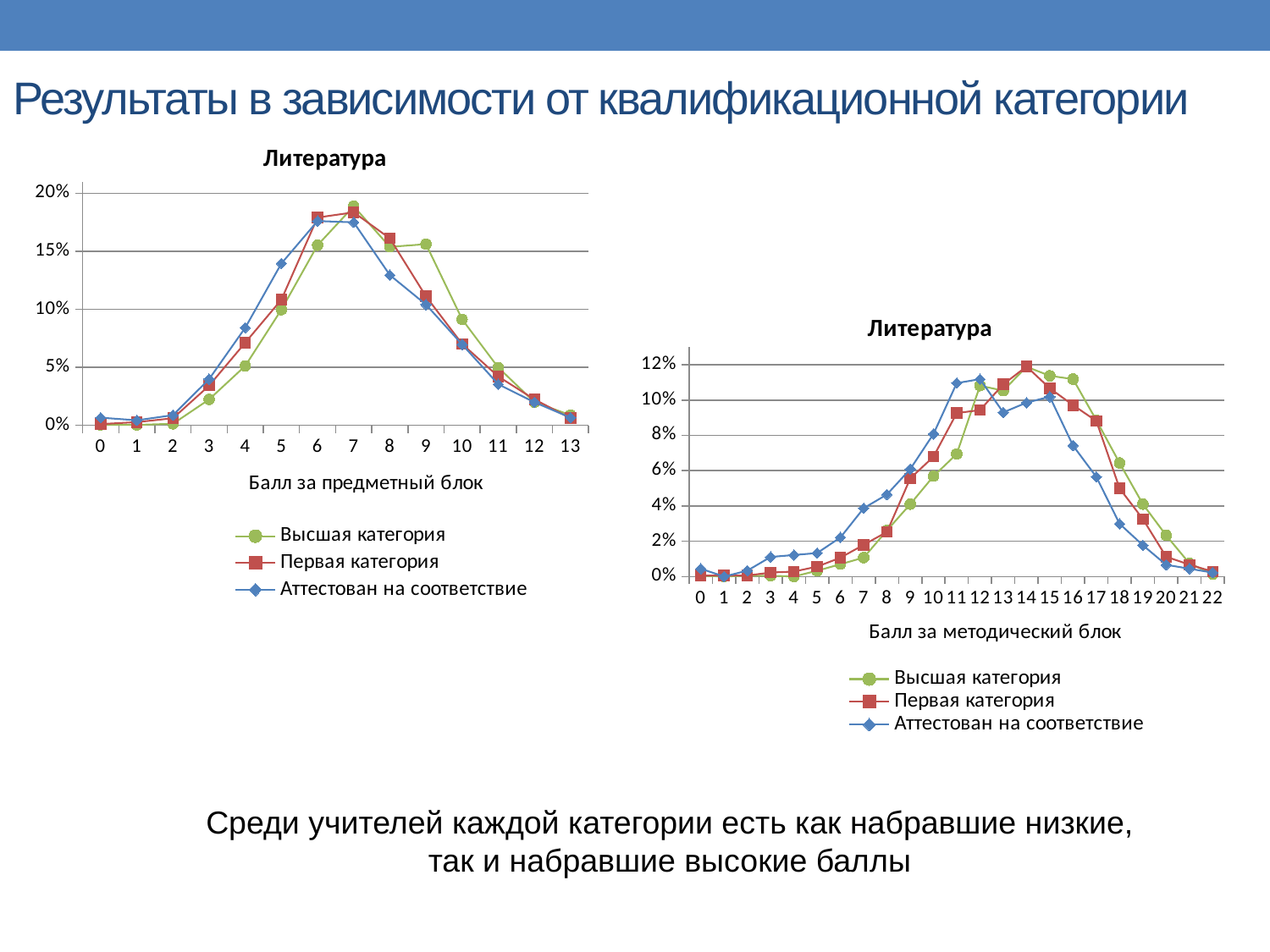
In the right chart (Балл за методический блок), at score 16, which is larger: Высшая категория or Аттестован на соответствие? Высшая категория In the left chart (Балл за предметный блок), at score 5, which is larger: Аттестован на соответствие or Высшая категория? Аттестован на соответствие In the left chart (Балл за предметный блок), is the value for Высшая категория at score 7 greater or less than 15%? greater How many series does the legend of the left chart (Балл за предметный блок) list? 3 How many score points are plotted along the x axis of the right chart (Балл за методический блок)? 23 How many score points are plotted along the x axis of the left chart (Балл за предметный блок)? 14 In the right chart (Балл за методический блок), at which score does the Первая категория line reach its highest value? 14 In the right chart (Балл за методический блок), is the value for Аттестован на соответствие at score 18 greater or less than 4%? less In the left chart (Балл за предметный блок), at which score does the Высшая категория line reach its highest value? 7 In the left chart (Балл за предметный блок), at score 9, which is larger: Высшая категория or Первая категория? Высшая категория In the right chart (Балл за методический блок), does the Первая категория line rise or fall from score 14 to score 22? fall What type of chart is the left chart (Балл за предметный блок)? line chart